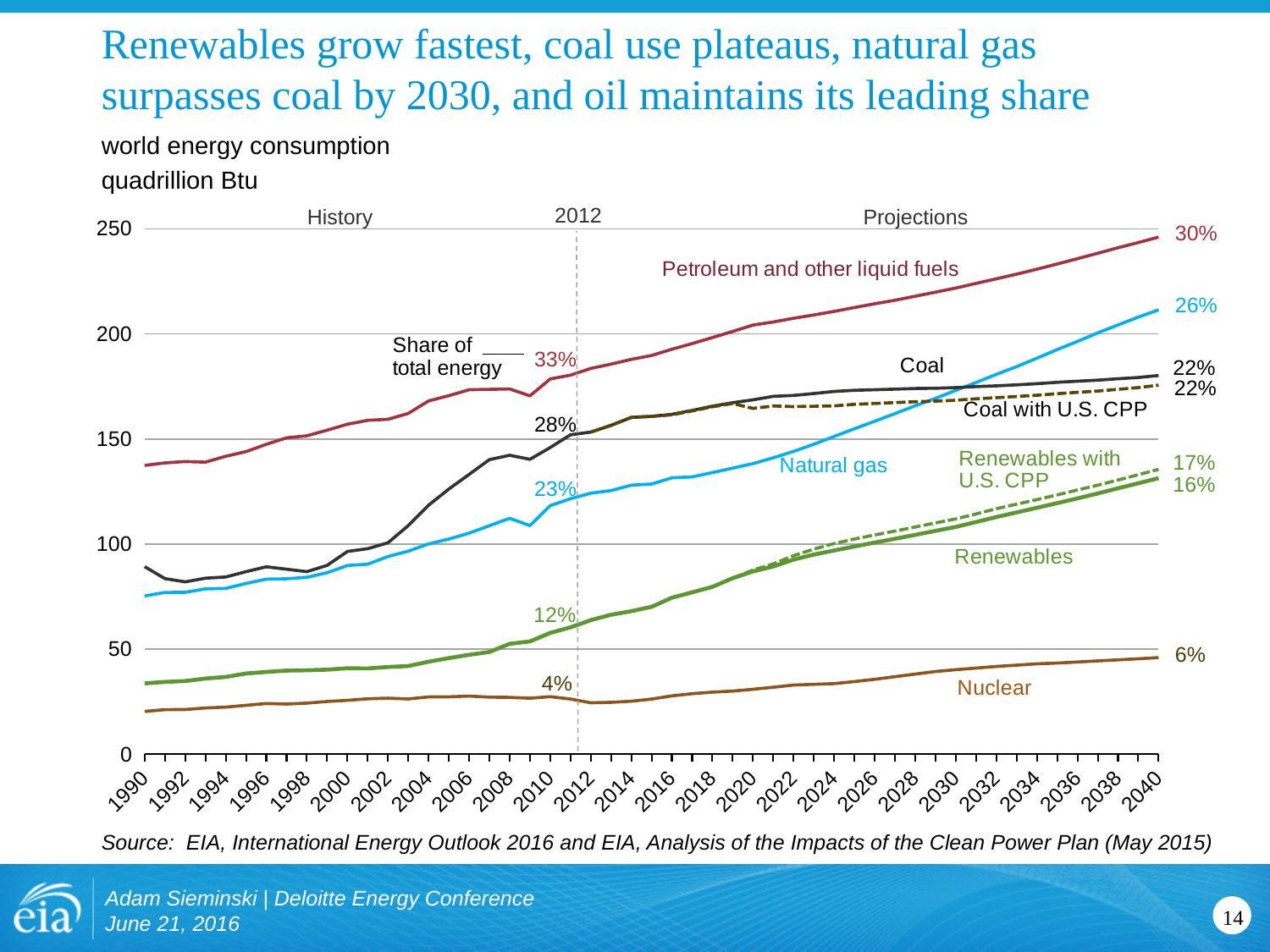
What unit is world energy consumption measured in on the chart? quadrillion Btu In 2040, which is larger: natural gas consumption or coal consumption? Natural gas What kind of chart is shown on the slide? line chart Which energy source has the lowest consumption in 2040? Nuclear By how many percentage points does the share of petroleum and other liquid fuels change from 2012 (33%) to 2040 (30%)? 3 percentage points What share of total energy does nuclear have in 2012? 4% Is the value for nuclear in 2040 greater or less than 50 quadrillion Btu? less What share of total energy does petroleum and other liquid fuels have in 2012? 33% What share of total energy do renewables with U.S. CPP have in 2040? 17% How many energy source lines are labeled on the chart? 7 What share of total energy does natural gas have in 2040? 26% Which energy source has the highest consumption in 2040? Petroleum and other liquid fuels